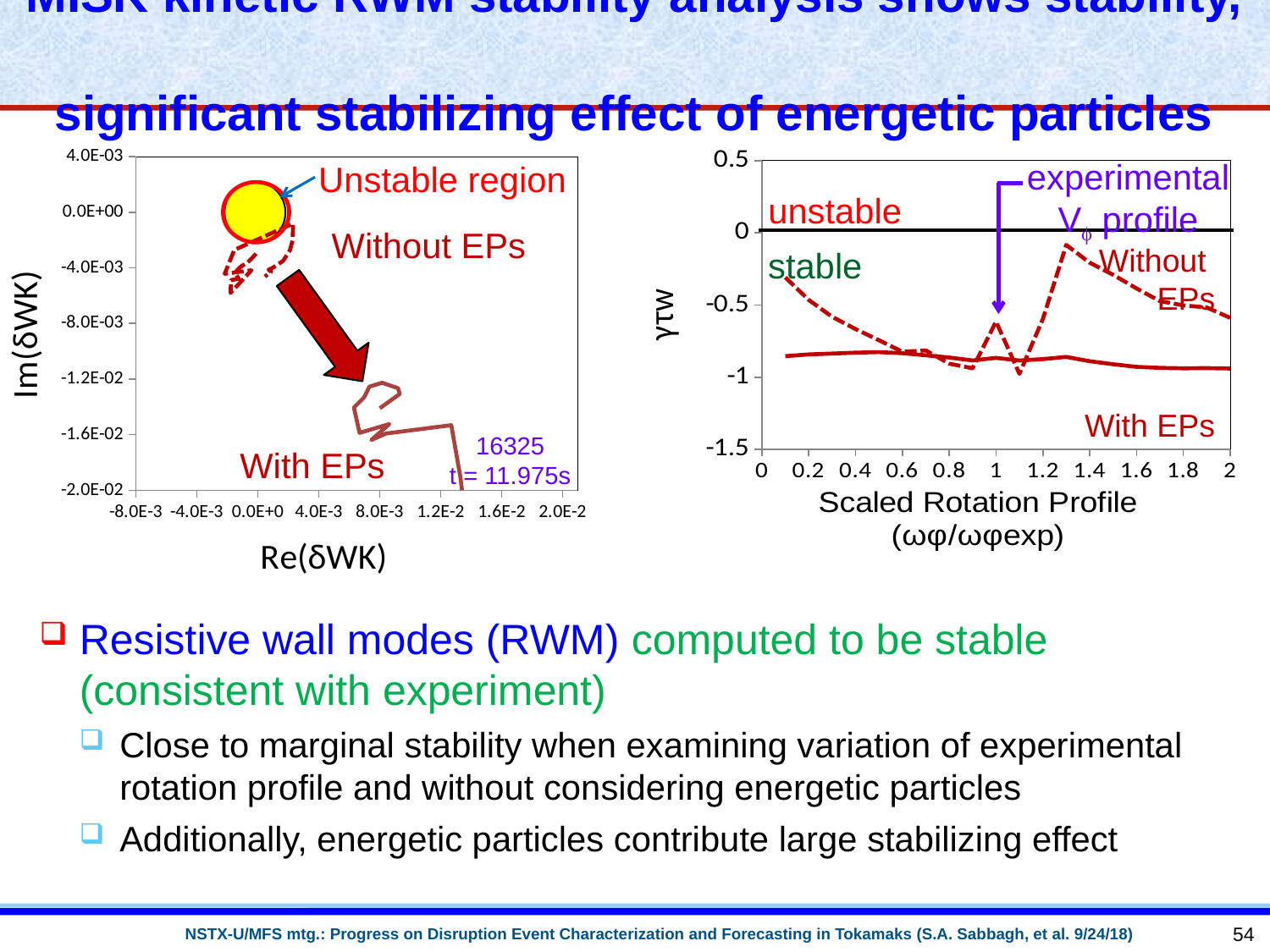
In the right-hand chart, what is the y-axis label? γτw In the left-hand chart, what is the x-axis label? Re(δWK) In the right-hand chart, what is the highest value shown on the y-axis? 0.5 In the right-hand chart, does the 'Without EPs' curve rise or fall as the scaled rotation profile goes from 1.3 to 2? fall What kind of chart is the right-hand chart (γτw versus Scaled Rotation Profile)? line chart In the right-hand chart, at a scaled rotation profile of 2, which curve has the higher γτw value, 'With EPs' or 'Without EPs'? Without EPs In the right-hand chart, is the value of the 'With EPs' curve at a scaled rotation profile of 1 greater or less than -0.5? less In the right-hand chart, how many curves are plotted? 2 In the left-hand chart, which curve reaches lower Im(δWK) values, 'With EPs' or 'Without EPs'? With EPs In the right-hand chart, is the value of the 'Without EPs' curve at a scaled rotation profile of 1.3 greater or less than -0.5? greater